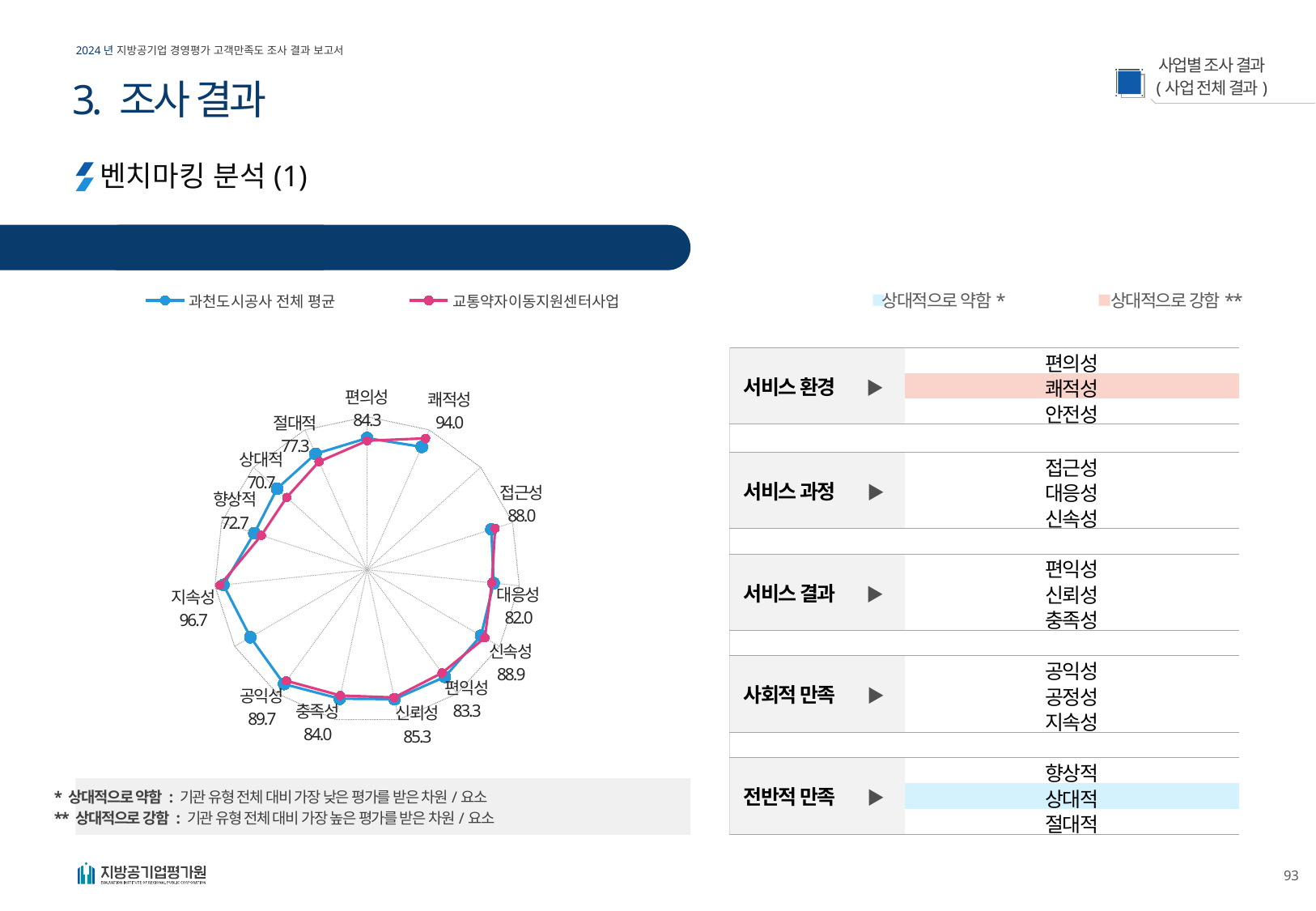
What is the difference between the printed values for 쾌적성 and 편의성? 9.7 What value is printed for 신뢰성 on the radar chart? 85.3 What value is printed for 쾌적성 on the radar chart? 94.0 Which has the larger printed value, 접근성 or 대응성? 접근성 What value is printed for 상대적 on the radar chart? 70.7 Which category has the lowest printed value on the radar chart? 상대적 Which category has the highest printed value on the radar chart? 지속성 What kind of chart is shown on the slide? radar chart How many series does the chart legend list? 2 What value is printed for 지속성 on the radar chart? 96.7 What are the two series names shown in the chart legend? 과천도시공사 전체 평균, 교통약자이동지원센터사업 How many categories (axes) does the radar chart have? 15